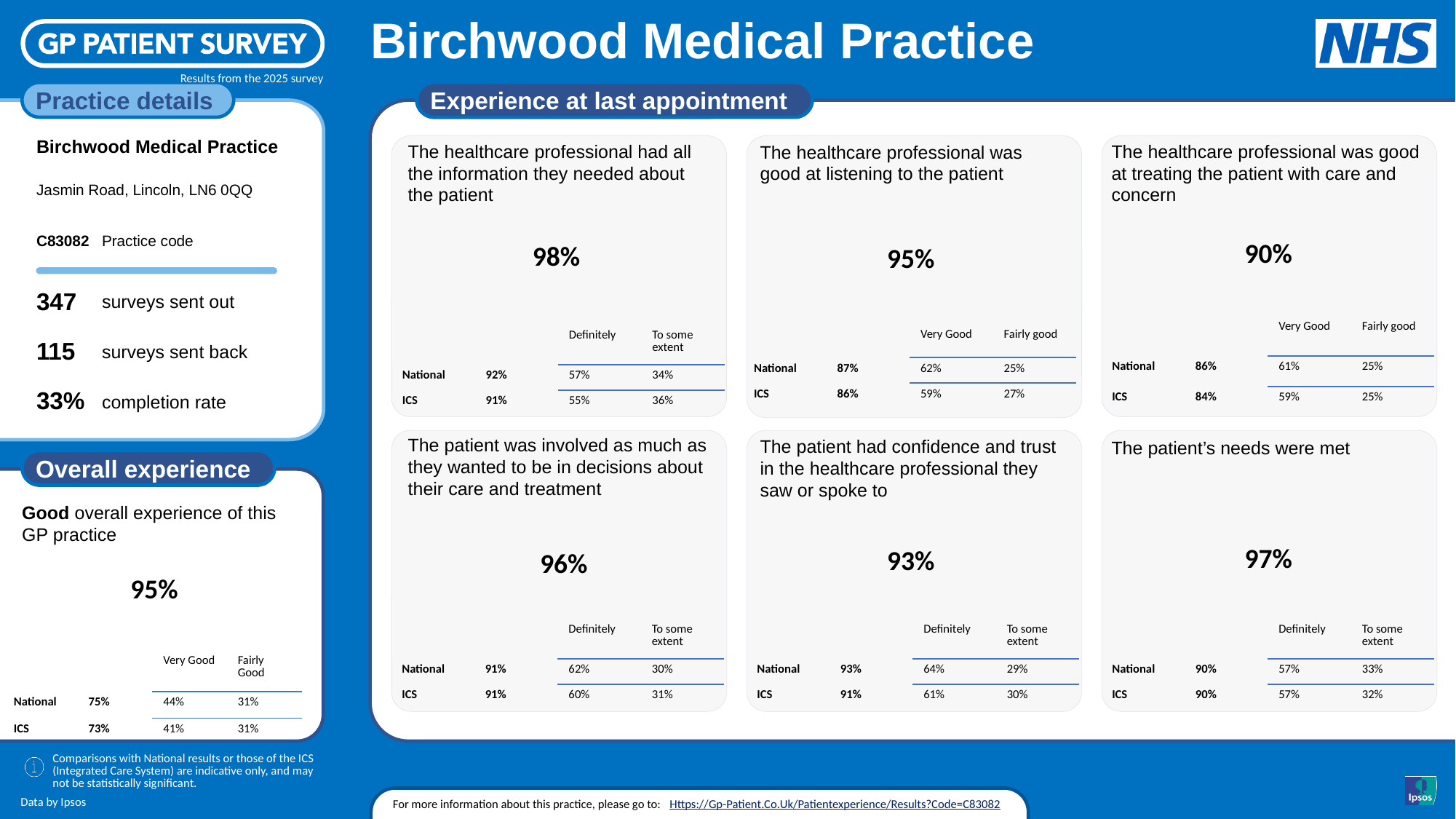
In the 'Experience at last appointment' section, what percentage is shown for 'The healthcare professional had all the information they needed about the patient'? 98% In the 'Experience at last appointment' section, which of the six statements has the lowest practice percentage? The healthcare professional was good at treating the patient with care and concern How many statement panels are shown in the 'Experience at last appointment' section? 6 In the 'Overall experience' panel, what is the National figure for good overall experience? 75% In the 'Overall experience' panel, what percentage of patients reported a good overall experience of this GP practice? 95% In the panel 'The patient's needs were met', what is the ICS 'To some extent' figure? 32% In the 'Overall experience' panel, what is the ICS 'Very Good' figure? 41% In the panel 'The healthcare professional was good at treating the patient with care and concern', what is the ICS overall figure? 84% In the panel 'The healthcare professional was good at listening to the patient', what is the difference between the practice percentage (95%) and the National percentage (87%)? 8 percentage points In the panel 'The patient had confidence and trust in the healthcare professional they saw or spoke to', what is the National 'Definitely' figure? 64% In the 'Experience at last appointment' section, which of the six statements has the highest practice percentage? The healthcare professional had all the information they needed about the patient Which is larger: the practice percentage for 'The patient was involved as much as they wanted to be in decisions about their care and treatment' or for 'The patient had confidence and trust in the healthcare professional they saw or spoke to'? The patient was involved as much as they wanted to be in decisions about their care and treatment (96%)